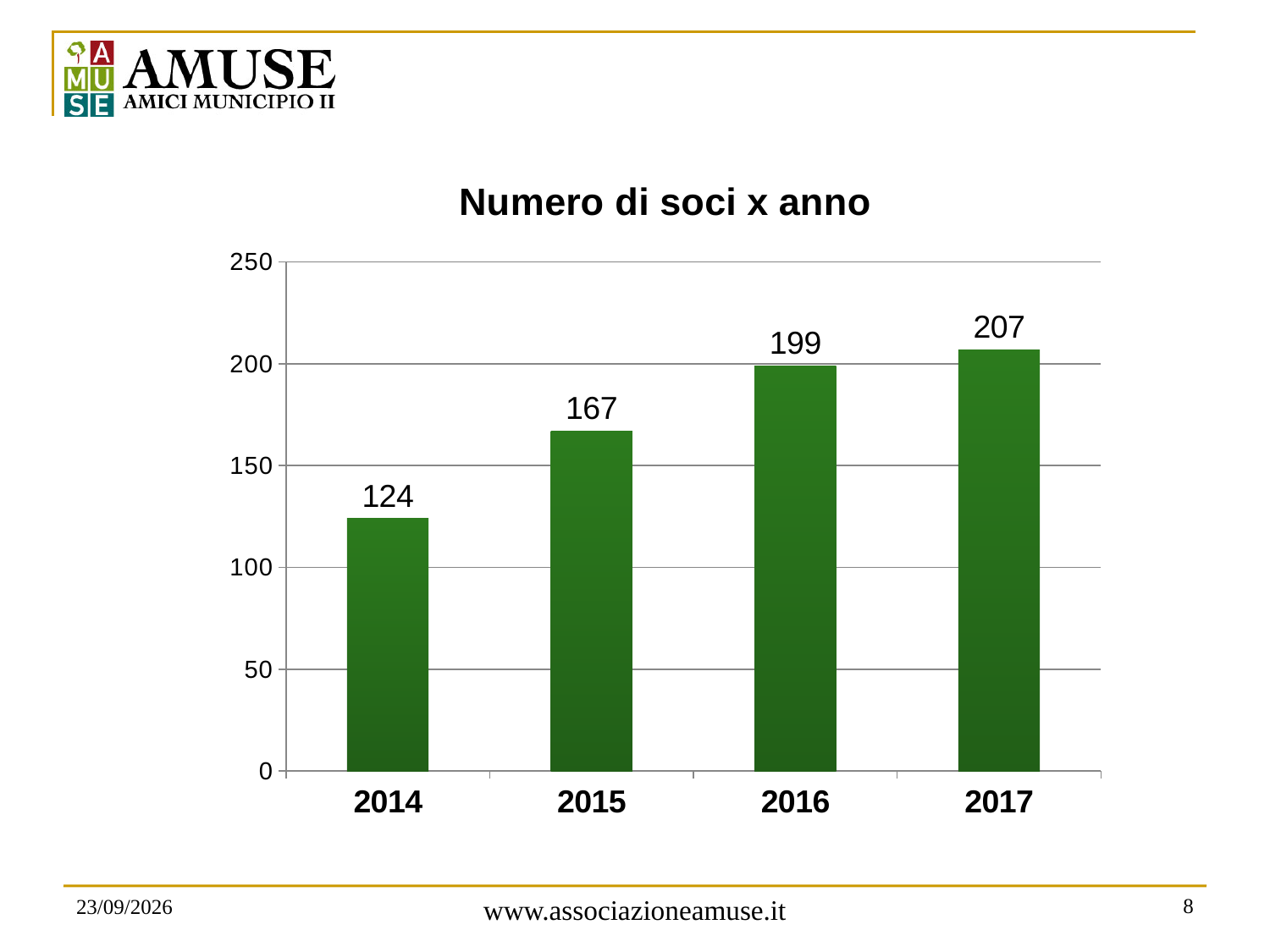
What is the value for 2017? 207 What is the difference between the values for 2017 and 2016? 8 Is the value for 2015 greater or less than 150? greater What kind of chart is shown? bar chart What is the difference between the values for 2015 and 2014? 43 How many years are shown on the x axis? 4 Which is larger, the value for 2015 or the value for 2016? 2016 What is the value for 2016? 199 What is the value for 2014? 124 Which year has the lowest value? 2014 Which year has the highest value? 2017 Do the values rise or fall from 2014 to 2017? rise